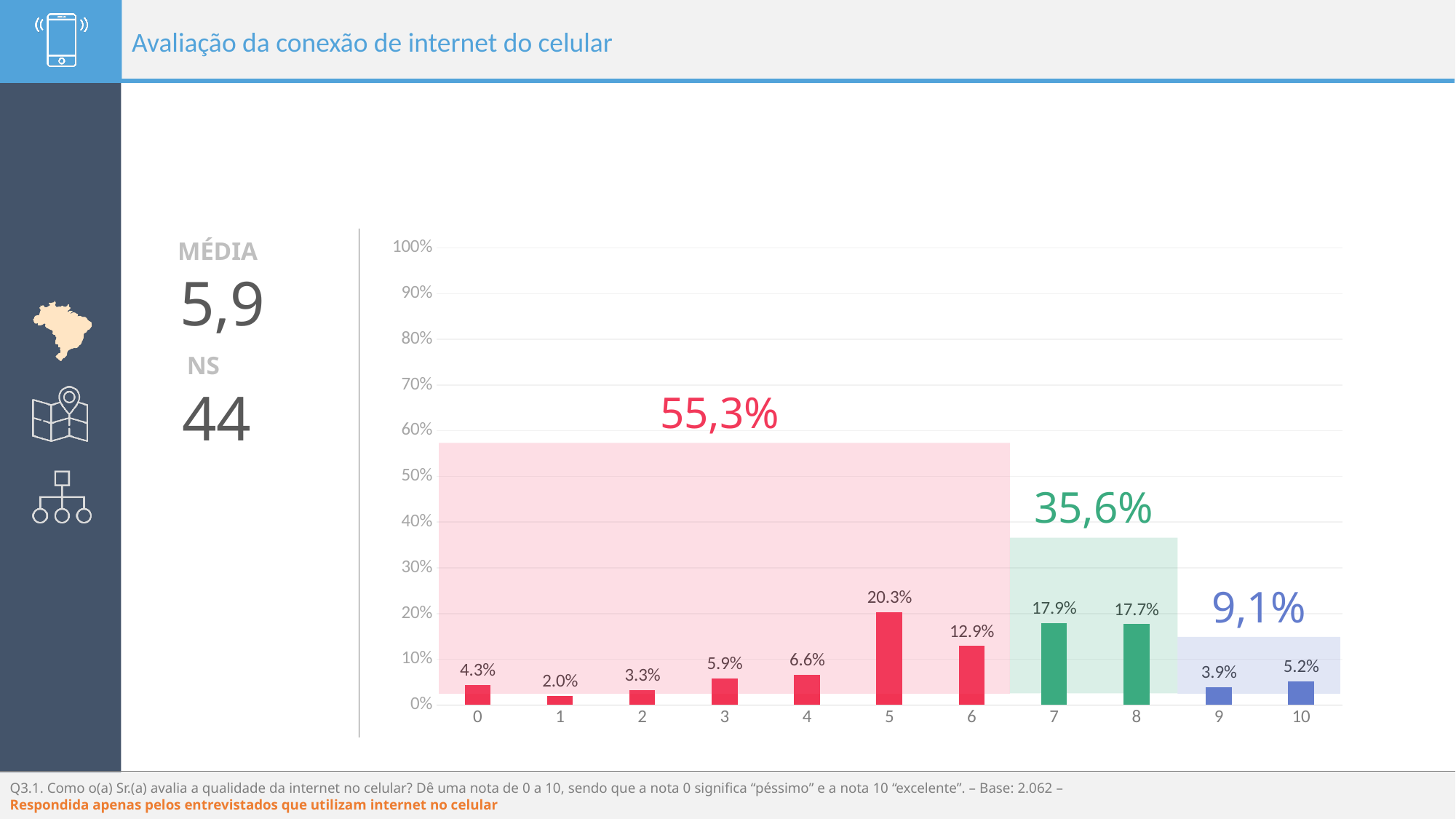
Which score has the highest percentage of respondents? 5 What type of chart is shown on the slide? bar chart What combined percentage is shown for the group of scores 7 and 8? 35,6% What percentage of respondents gave a score of 10? 5.2% Which has a larger percentage: score 4 or score 3? score 4 How many score categories are shown on the x axis? 11 What percentage of respondents gave a score of 5? 20.3% Is the value for score 6 greater or less than 10%? greater What is the difference in percentage points between the score 5 bar and the score 6 bar? 7.4 What percentage of respondents gave a score of 0? 4.3% Which score has the lowest percentage of respondents? 1 What is the average (MÉDIA) score shown on the slide? 5,9